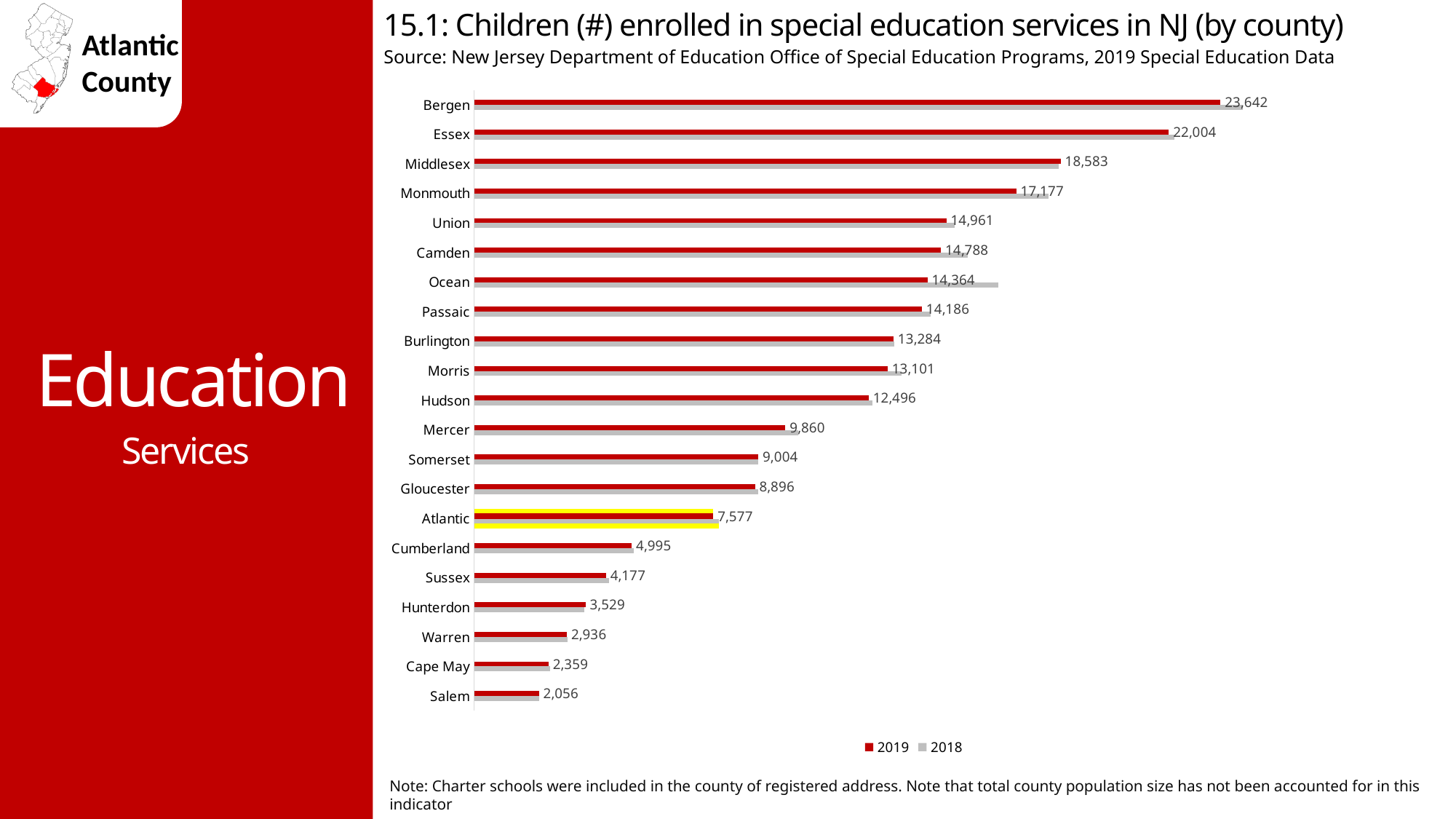
Which county has the lowest number of children enrolled in special education services in 2019? Salem How many counties are shown in the chart? 21 Which county has the highest number of children enrolled in special education services in 2019? Bergen How many children were enrolled in special education services in Bergen County in 2019? 23,642 What is the difference between the 2019 values for Atlantic and Cumberland? 2,582 What kind of chart is shown on the slide? Bar chart How many series does the legend list? 2 For Ocean County, was the 2018 or the 2019 value larger? 2018 What is the difference between the 2019 values for Bergen and Essex? 1,638 What is the 2019 value shown for Atlantic County? 7,577 Which county had a larger 2019 value, Mercer or Somerset? Mercer What is the 2019 value shown for Salem County? 2,056